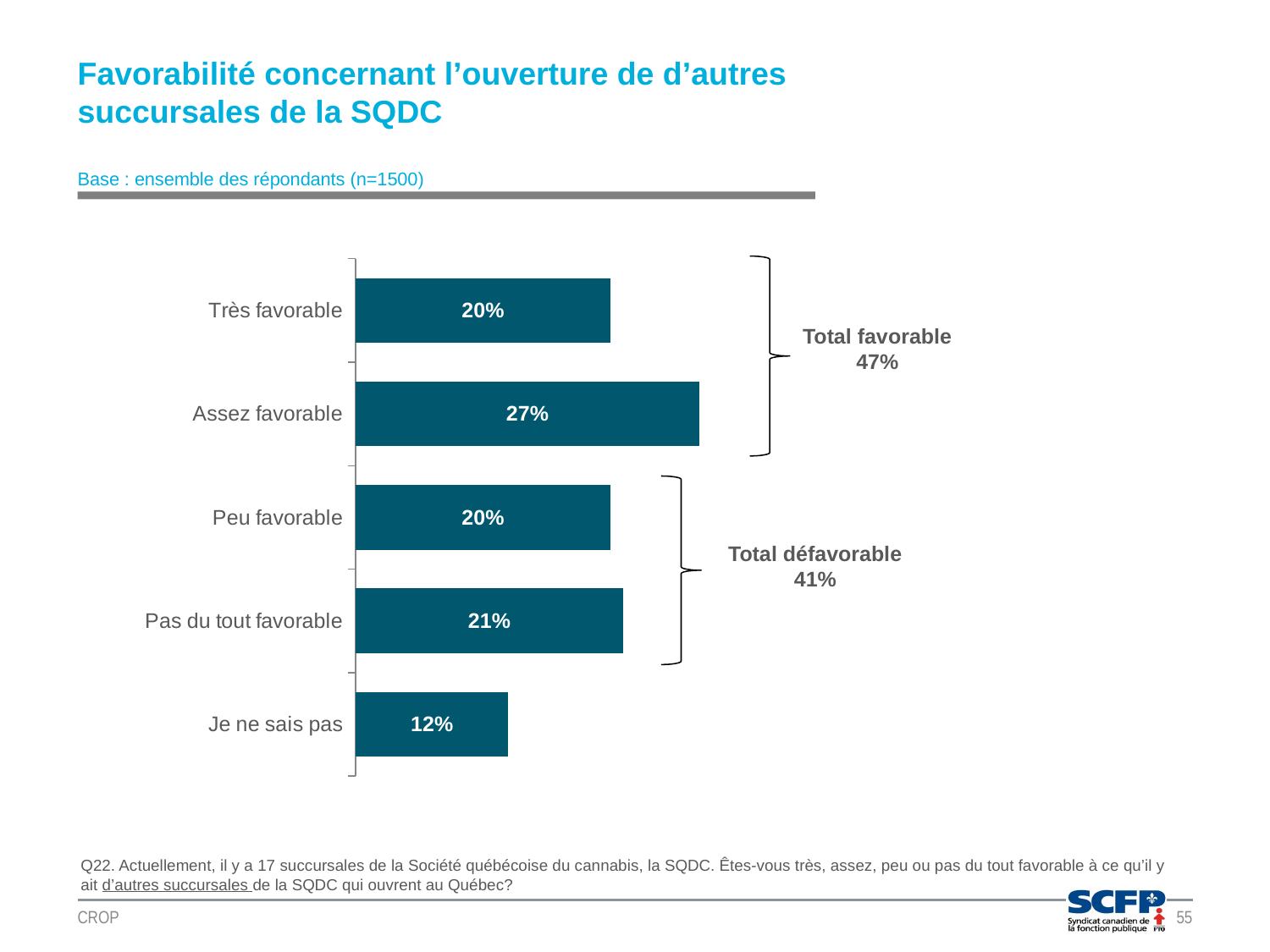
What kind of chart is shown on the slide? Bar chart What is the "Total défavorable" value shown next to the chart? 41% Which category has the highest value? Assez favorable Which is larger, "Assez favorable" or "Pas du tout favorable"? Assez favorable What is the value for "Je ne sais pas"? 12% Which category has the lowest value? Je ne sais pas How many categories are shown in the chart? 5 What is the value for "Pas du tout favorable"? 21% What is the "Total favorable" value shown next to the chart? 47% What is the value for "Très favorable"? 20% What is the difference between "Assez favorable" and "Je ne sais pas"? 15% What is the value for "Assez favorable"? 27%